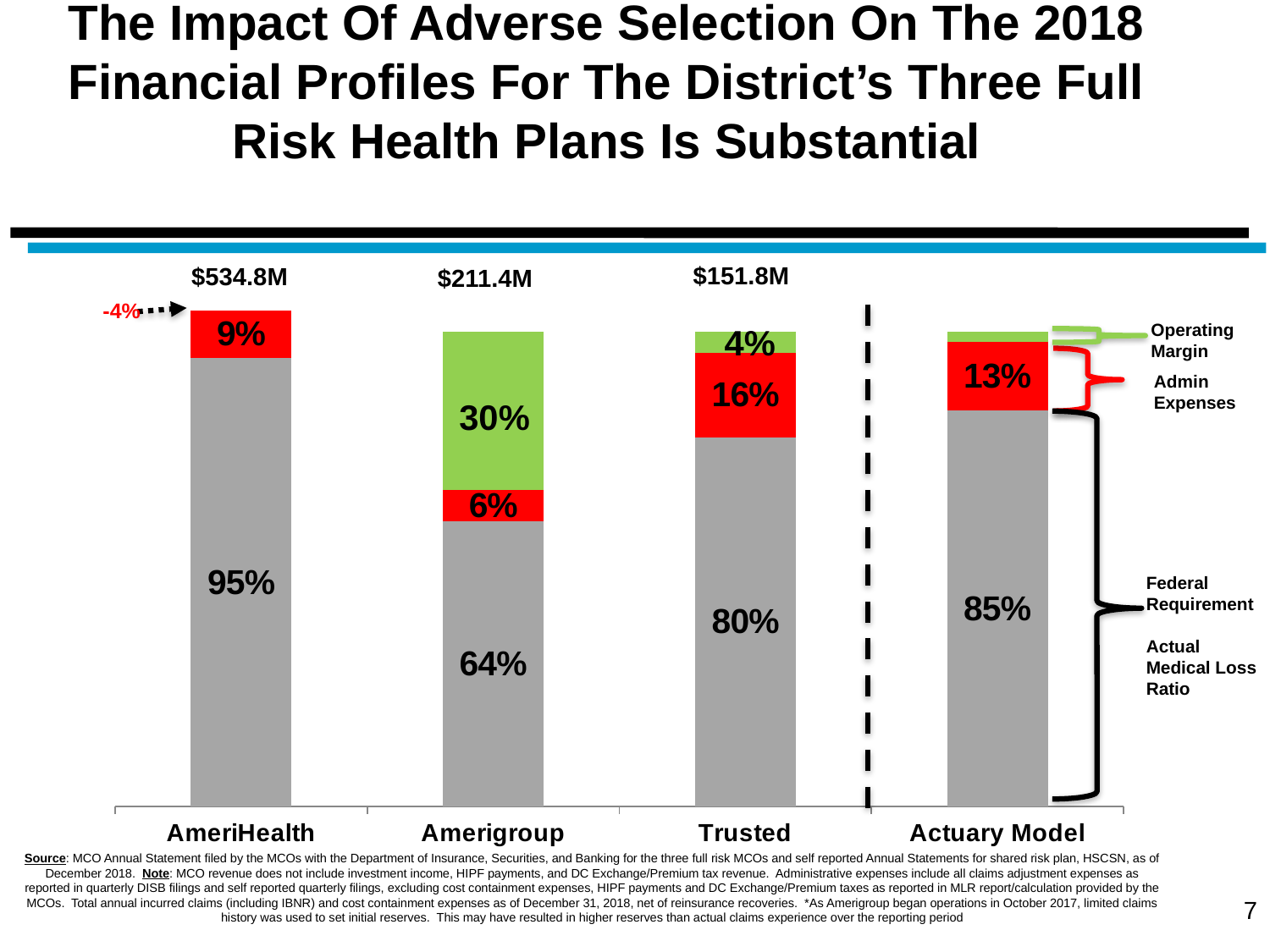
What revenue figure is shown above the AmeriHealth bar? $534.8M How many bars (categories) are shown on the x axis? 4 What is the medical loss ratio (gray segment) for the Actuary Model? 85% What operating margin value is shown for AmeriHealth? -4% Which is larger, the medical loss ratio of Trusted or of the Actuary Model? Actuary Model Which plan has the lowest medical loss ratio (gray segment)? Amerigroup What is the operating margin (green segment) value for Amerigroup? 30% What is the admin expenses (red segment) value for Trusted? 16% Which bar has the highest admin expenses (red segment) value? Trusted What is the medical loss ratio (gray segment) for AmeriHealth? 95% What is the difference between the admin expenses of Trusted and Amerigroup? 10% What kind of chart is shown on the slide? Stacked bar chart